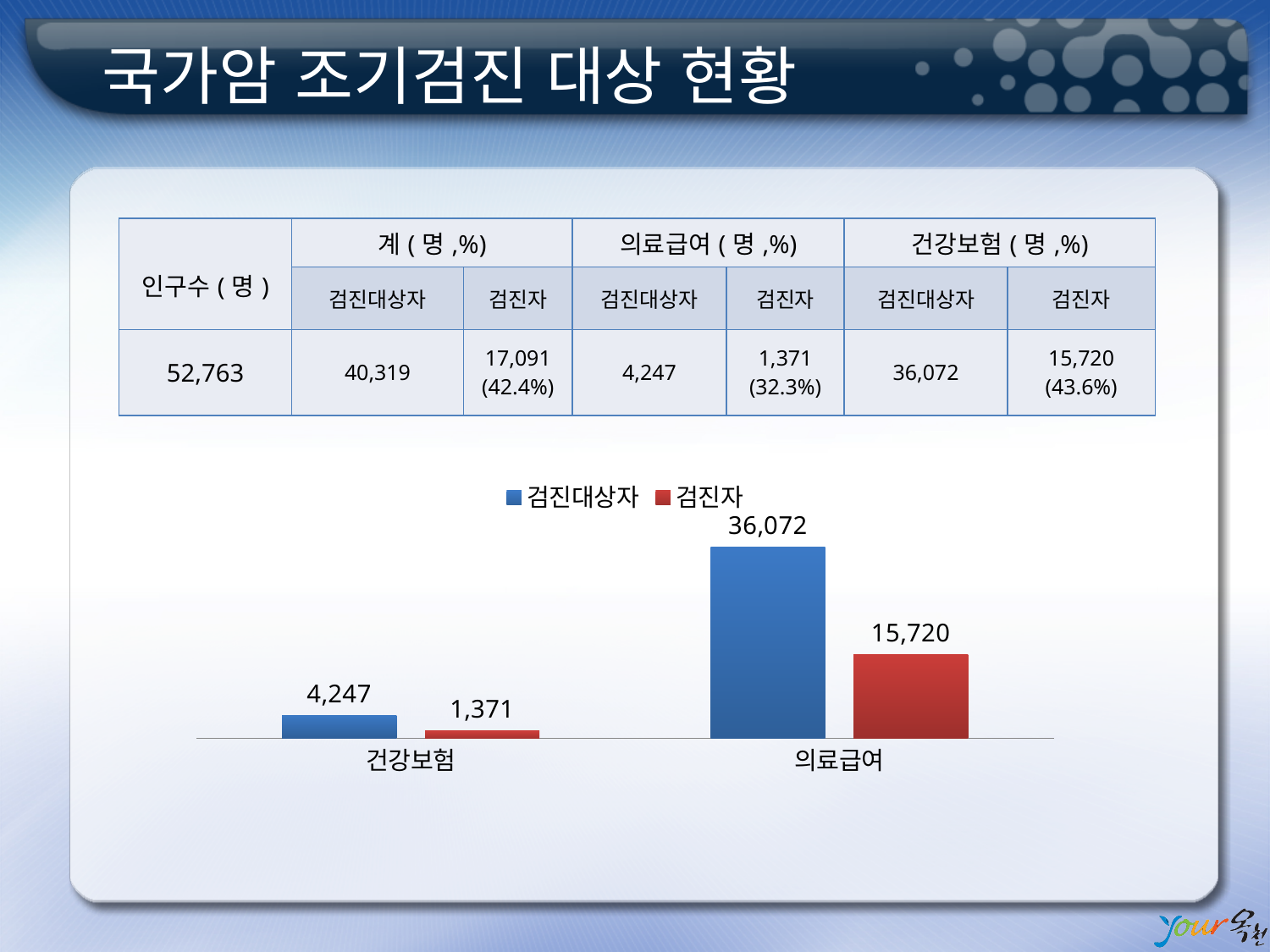
What is the value of 검진자 for 건강보험 in the chart? 1,371 What is the value of 검진대상자 for 의료급여 in the chart? 36,072 How many categories are shown on the x axis of the chart? 2 What type of chart is shown on the slide? bar chart Which category has the highest 검진대상자 value in the chart? 의료급여 Which is larger in the chart: 검진자 for 의료급여 or 검진대상자 for 건강보험? 검진자 for 의료급여 Which colour represents the 검진자 series in the chart? red What is the value of 검진대상자 for 건강보험 in the chart? 4,247 How many series does the chart legend list? 2 What is the difference between 검진대상자 and 검진자 for 의료급여 in the chart? 20,352 What is the value of 검진자 for 의료급여 in the chart? 15,720 Which category has the lowest 검진자 value in the chart? 건강보험